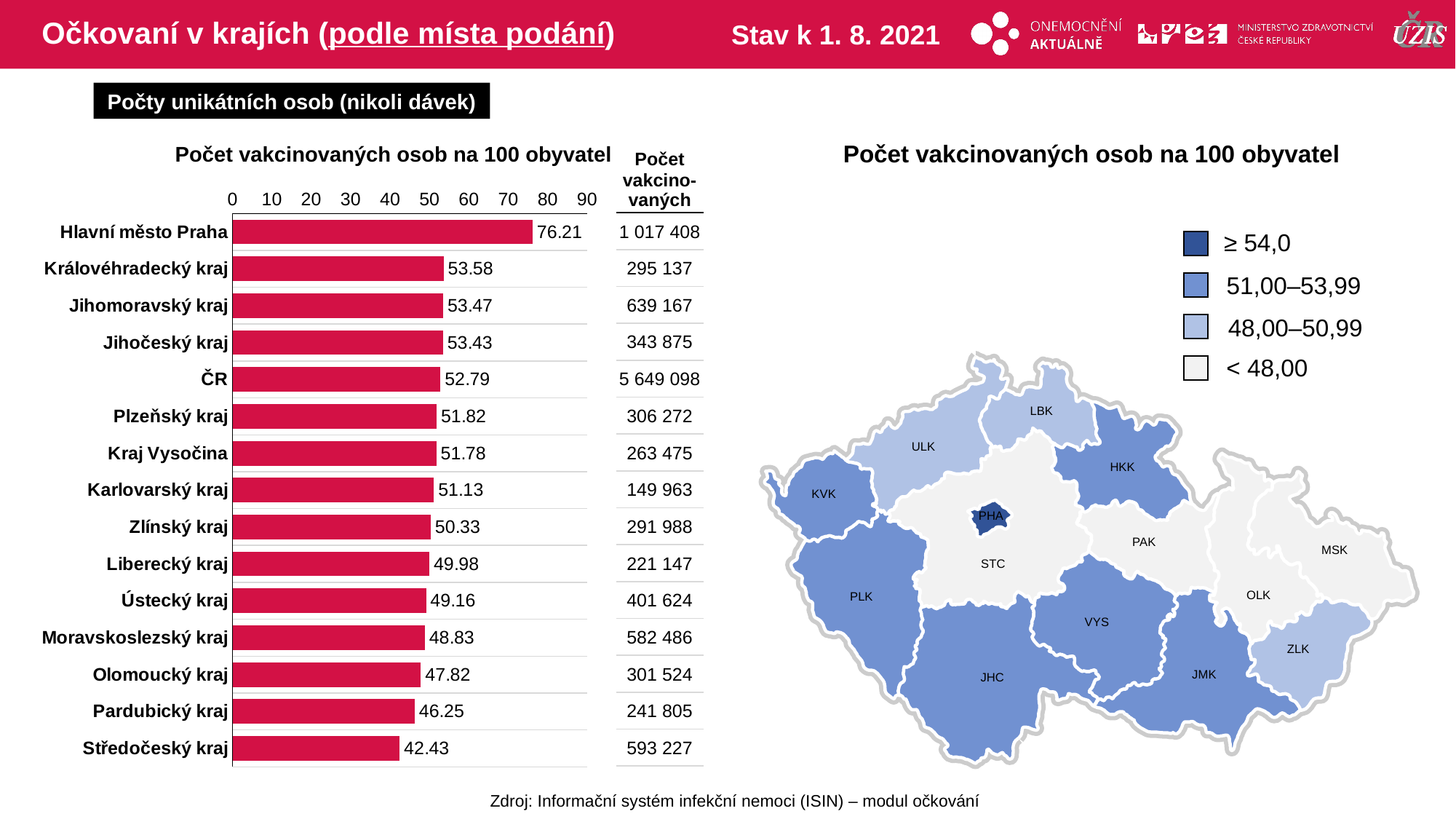
How many bars are shown in the bar chart? 15 In the bar chart, what is the difference between the values for Hlavní město Praha and Středočeský kraj? 33.78 In the bar chart, is the value for Olomoucký kraj greater or less than 50? less In the bar chart, which region has the highest value? Hlavní město Praha What kind of chart is shown on the left of the slide? bar chart In the bar chart, what is the value for Hlavní město Praha? 76.21 In the bar chart, what is the value for Zlínský kraj? 50.33 In the bar chart, which has a larger value, Jihomoravský kraj or Ústecký kraj? Jihomoravský kraj What is the title of the bar chart on the left? Počet vakcinovaných osob na 100 obyvatel In the bar chart, what is the difference between the values for Královéhradecký kraj and Jihomoravský kraj? 0.11 In the bar chart, what is the value for ČR? 52.79 In the bar chart, which region has the lowest value? Středočeský kraj